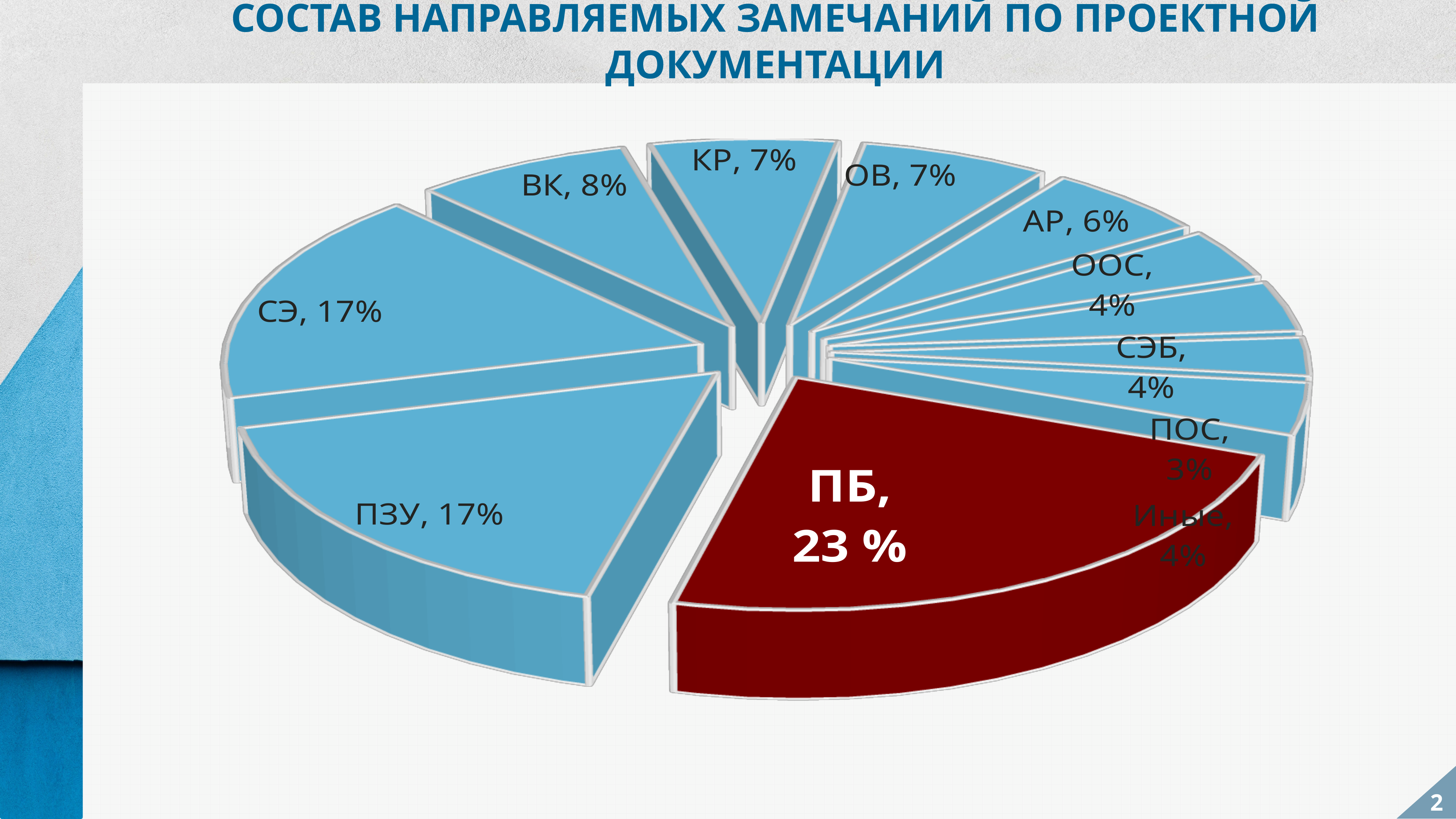
Which is larger, the share of ПЗУ or the share of ОВ? ПЗУ What kind of chart is shown on the slide? pie chart What is the value shown for ПОС? 3% What is the value shown for ПБ? 23 % What colour is the ПБ slice? dark red Which category has the largest share of the pie? ПБ What is the difference between the shares of ПБ and СЭ? 6% How many slices does the pie chart have? 11 What is the difference between the shares of ВК and КР? 1% What is the value shown for ВК? 8% What is the value shown for АР? 6% Which category has the smallest share of the pie? ПОС